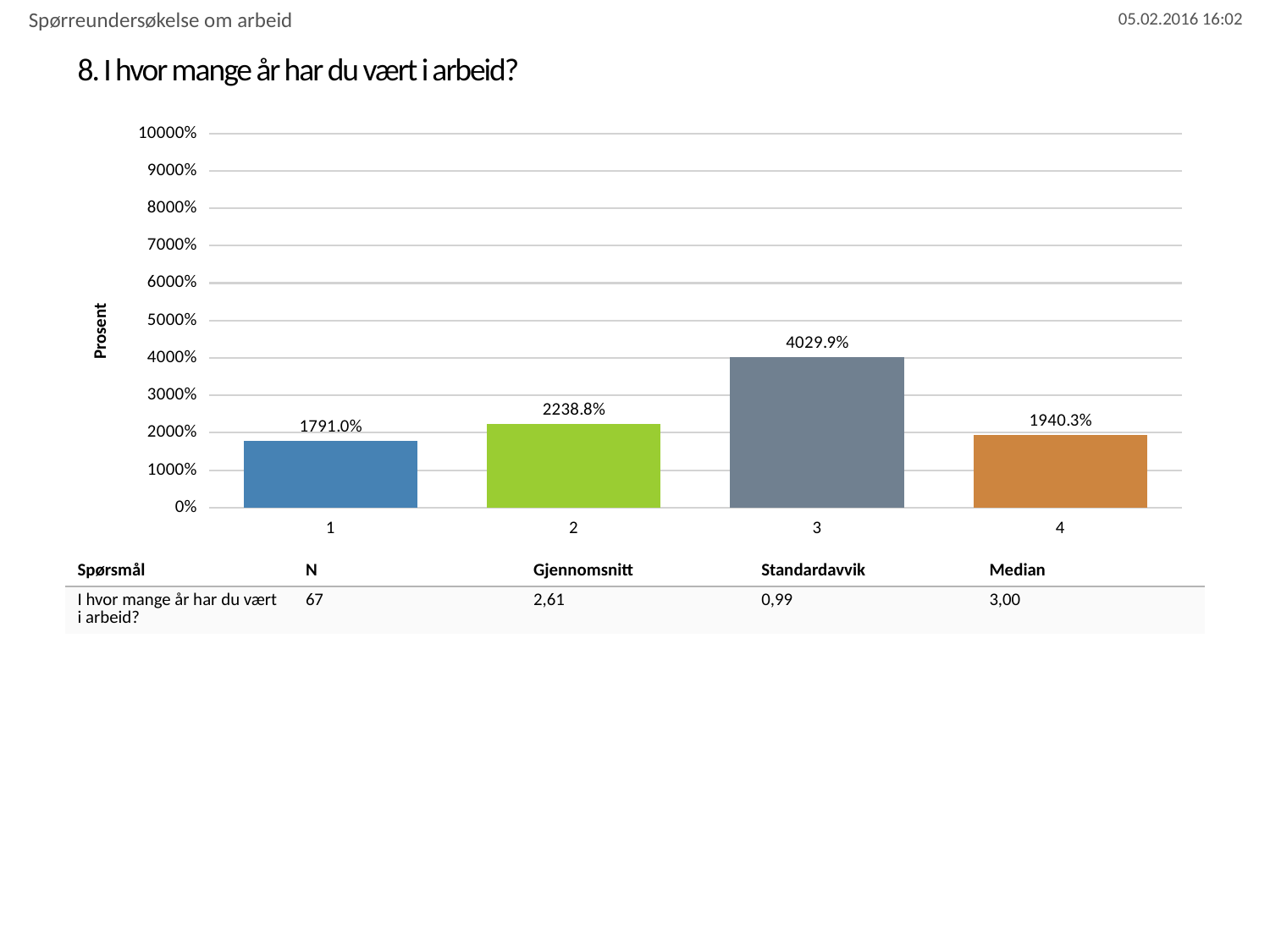
How many categories are shown on the x axis? 4 What is the value for category 1? 1791.0% What is the difference between the values for category 2 and category 4? 298.5% Which is larger, the value for category 2 or the value for category 4? category 2 Which category has the highest value? 3 What is the label of the y axis? Prosent Which category has the lowest value? 1 What is the value for category 4? 1940.3% What kind of chart is shown on the slide? bar chart What is the difference between the values for category 3 and category 1? 2238.9% Is the value for category 3 greater or less than 3000%? greater What is the value for category 3? 4029.9%